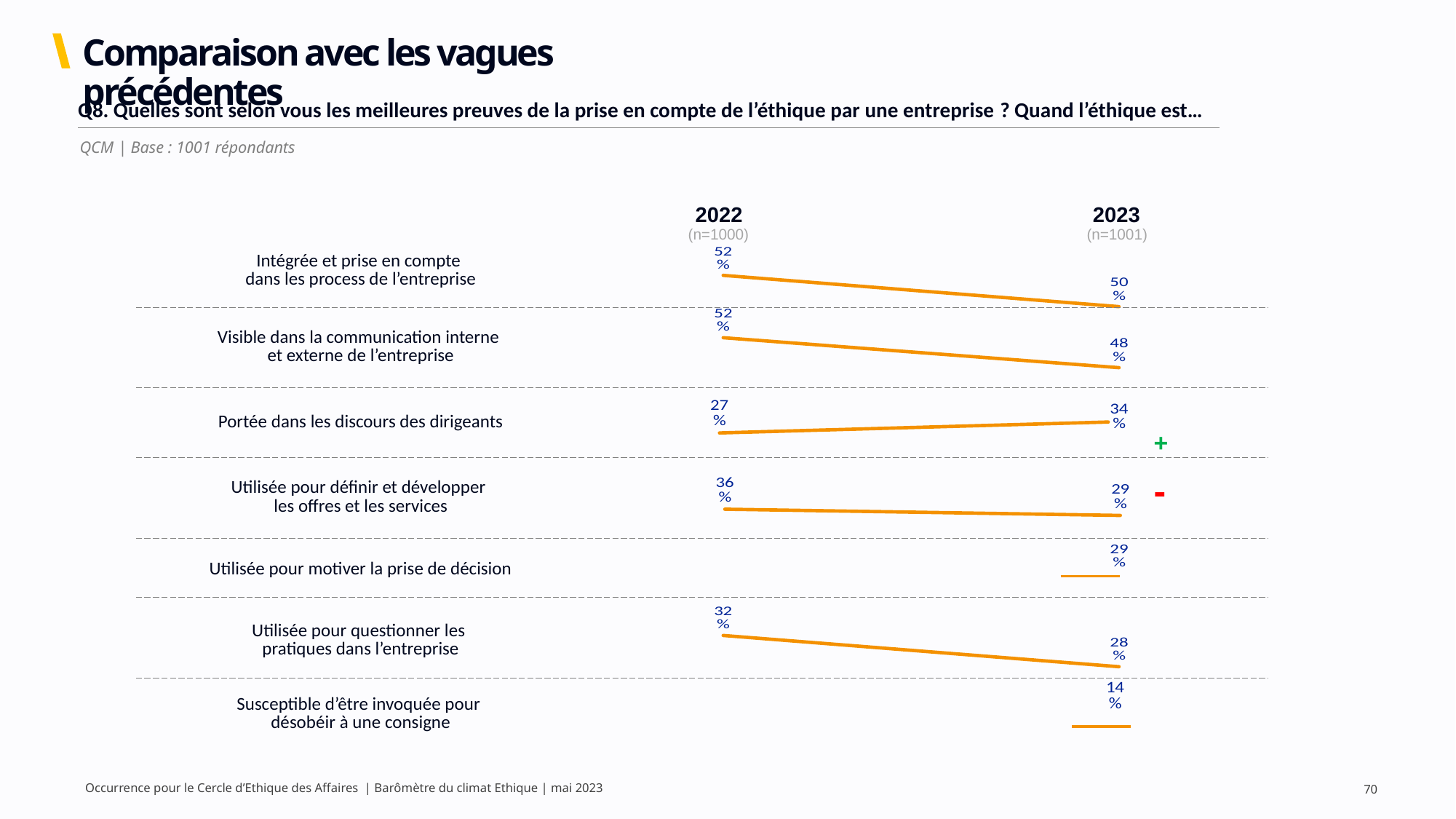
Did the value for "Utilisée pour questionner les pratiques dans l'entreprise" rise or fall from 2022 to 2023? Fall What is the 2023 value for "Susceptible d'être invoquée pour désobéir à une consigne"? 14% What is the 2022 value for "Utilisée pour questionner les pratiques dans l'entreprise"? 32% What is the 2022 value for "Utilisée pour définir et développer les offres et les services"? 36% By how many percentage points did "Portée dans les discours des dirigeants" change from 2022 to 2023? 7 points Which item has the lowest 2023 value? Susceptible d'être invoquée pour désobéir à une consigne What is the 2023 value for "Portée dans les discours des dirigeants"? 34% Which is larger: the 2022 value for "Utilisée pour définir et développer les offres et les services" or its 2023 value? 2022 (36%) How many items (categories) are listed in the chart? 7 What is the difference between the 2022 and 2023 values for "Visible dans la communication interne et externe de l'entreprise"? 4 points What are the two waves (years) compared in the chart? 2022 and 2023 Which item has the highest 2023 value? Intégrée et prise en compte dans les process de l'entreprise